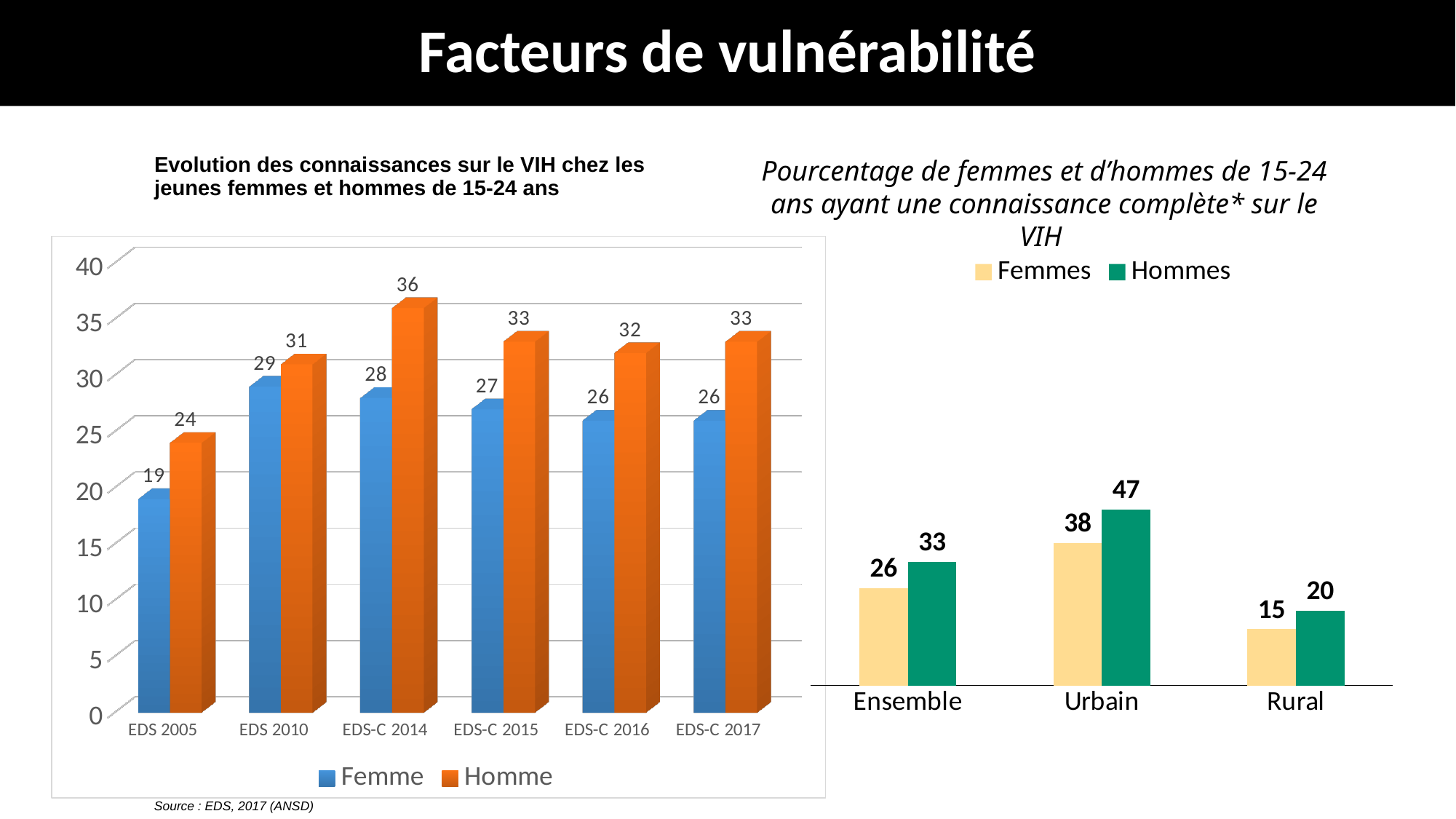
In the right chart (Pourcentage de femmes et d'hommes de 15-24 ans), which is larger: Femmes in Urbain or Hommes in Ensemble? Femmes in Urbain In the right chart (Pourcentage de femmes et d'hommes de 15-24 ans), what is the difference between Hommes and Femmes in Ensemble? 7 In the left chart (Evolution des connaissances sur le VIH), which survey has the highest Homme value? EDS-C 2014 In the left chart (Evolution des connaissances sur le VIH), what is the difference between the Homme and Femme values in EDS-C 2017? 7 In the right chart (Pourcentage de femmes et d'hommes de 15-24 ans), what is the value for Hommes in Urbain? 47 In the right chart (Pourcentage de femmes et d'hommes de 15-24 ans), which category has the lowest Femmes value? Rural In the left chart (Evolution des connaissances sur le VIH), how many surveys are shown on the x axis? 6 In the left chart (Evolution des connaissances sur le VIH), which survey has the lowest Femme value? EDS 2005 In the left chart (Evolution des connaissances sur le VIH), what is the value for Femme in EDS 2005? 19 What kind of chart is the left chart (Evolution des connaissances sur le VIH)? Bar chart In the left chart (Evolution des connaissances sur le VIH), how many series does the legend list? 2 In the left chart (Evolution des connaissances sur le VIH), what is the value for Homme in EDS-C 2014? 36